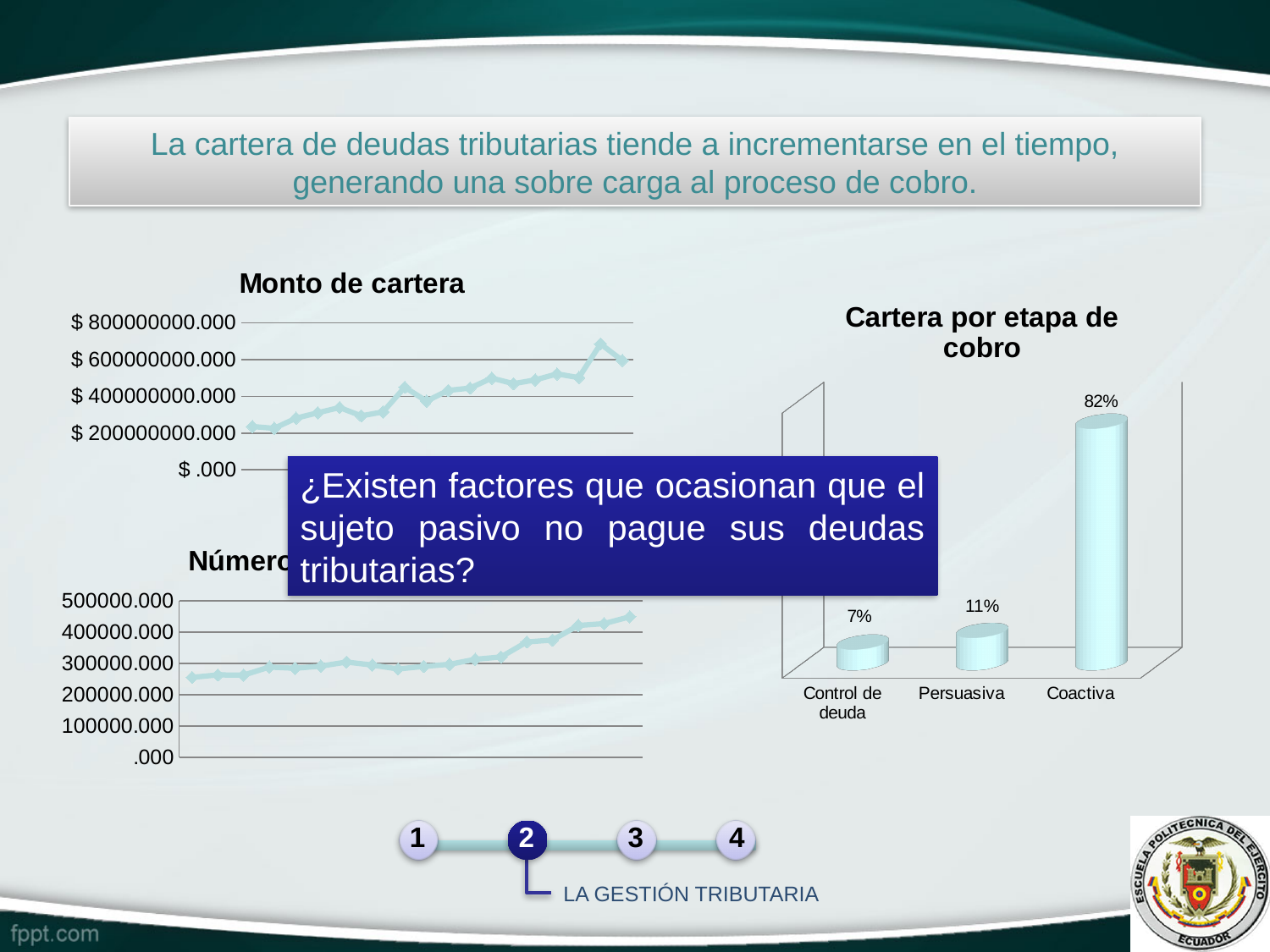
What kind of chart is 'Monto de cartera'? Line chart In the 'Cartera por etapa de cobro' chart, what is the value for Control de deuda? 7% In the 'Cartera por etapa de cobro' chart, which category has the lowest value? Control de deuda In the 'Cartera por etapa de cobro' chart, which is larger, Persuasiva or Control de deuda? Persuasiva In the 'Cartera por etapa de cobro' chart, which category has the highest value? Coactiva In the 'Cartera por etapa de cobro' chart, what is the value for Persuasiva? 11% In the 'Cartera por etapa de cobro' chart, what is the difference between the values for Coactiva and Persuasiva? 71% How many categories are shown in the 'Cartera por etapa de cobro' chart? 3 In the 'Cartera por etapa de cobro' chart, what is the value for Coactiva? 82% In the line chart at the bottom left of the slide, is the last plotted value greater or less than 400000.000? greater What kind of chart is 'Cartera por etapa de cobro'? Bar chart In the 'Monto de cartera' chart, do the values generally rise or fall along the x axis? Rise